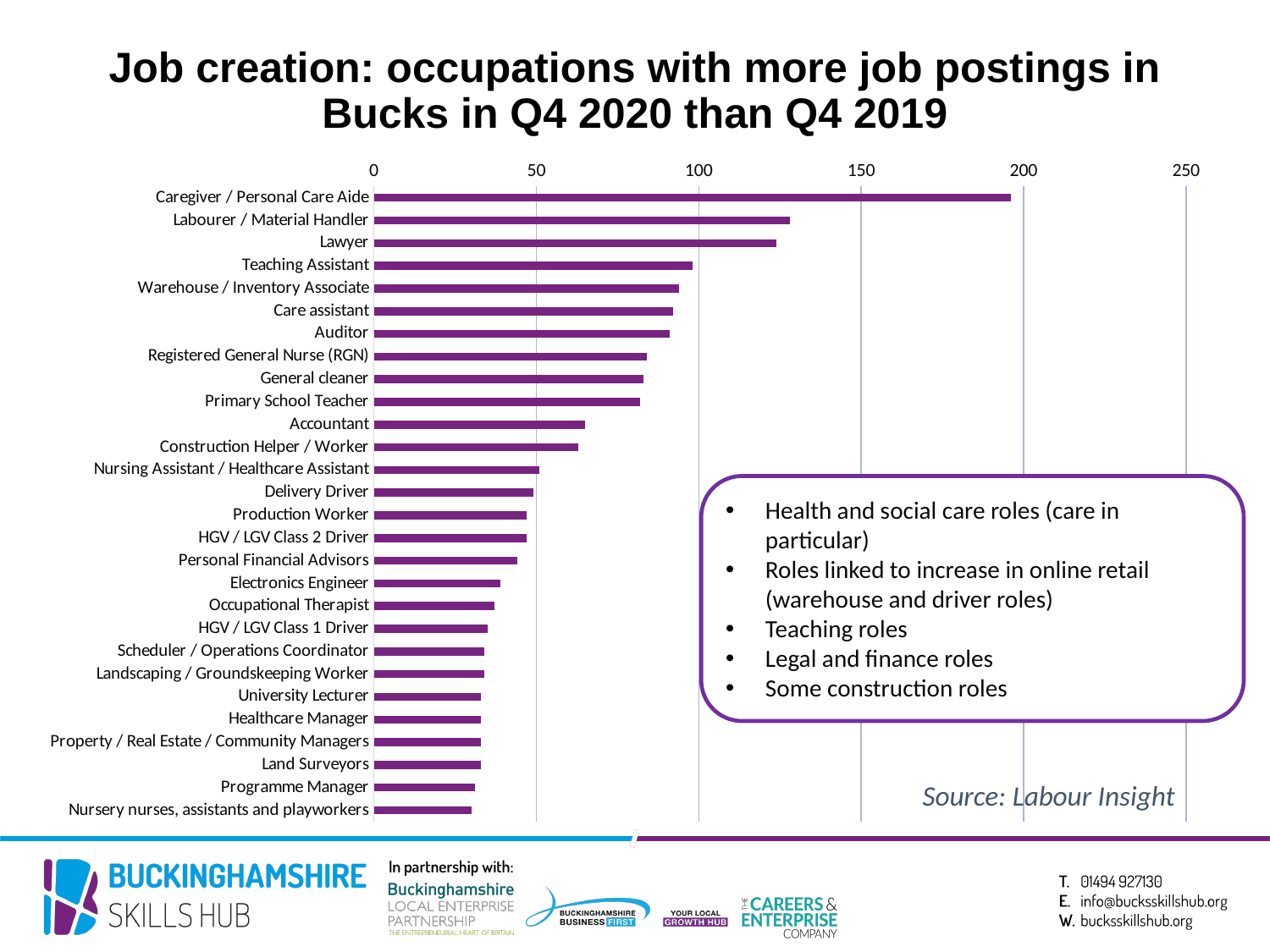
Is the value for Caregiver / Personal Care Aide greater or less than 150? greater What kind of chart is shown on the slide? Bar chart Is the value for Labourer / Material Handler greater or less than 100? greater How many occupations are listed in the chart? 28 Is the value for Electronics Engineer greater or less than 50? less Which has a larger value, Accountant or Occupational Therapist? Accountant What is the source cited for the chart data? Labour Insight Which has a larger value, Lawyer or Caregiver / Personal Care Aide? Caregiver / Personal Care Aide Which occupation has the highest number of job postings in the chart? Caregiver / Personal Care Aide